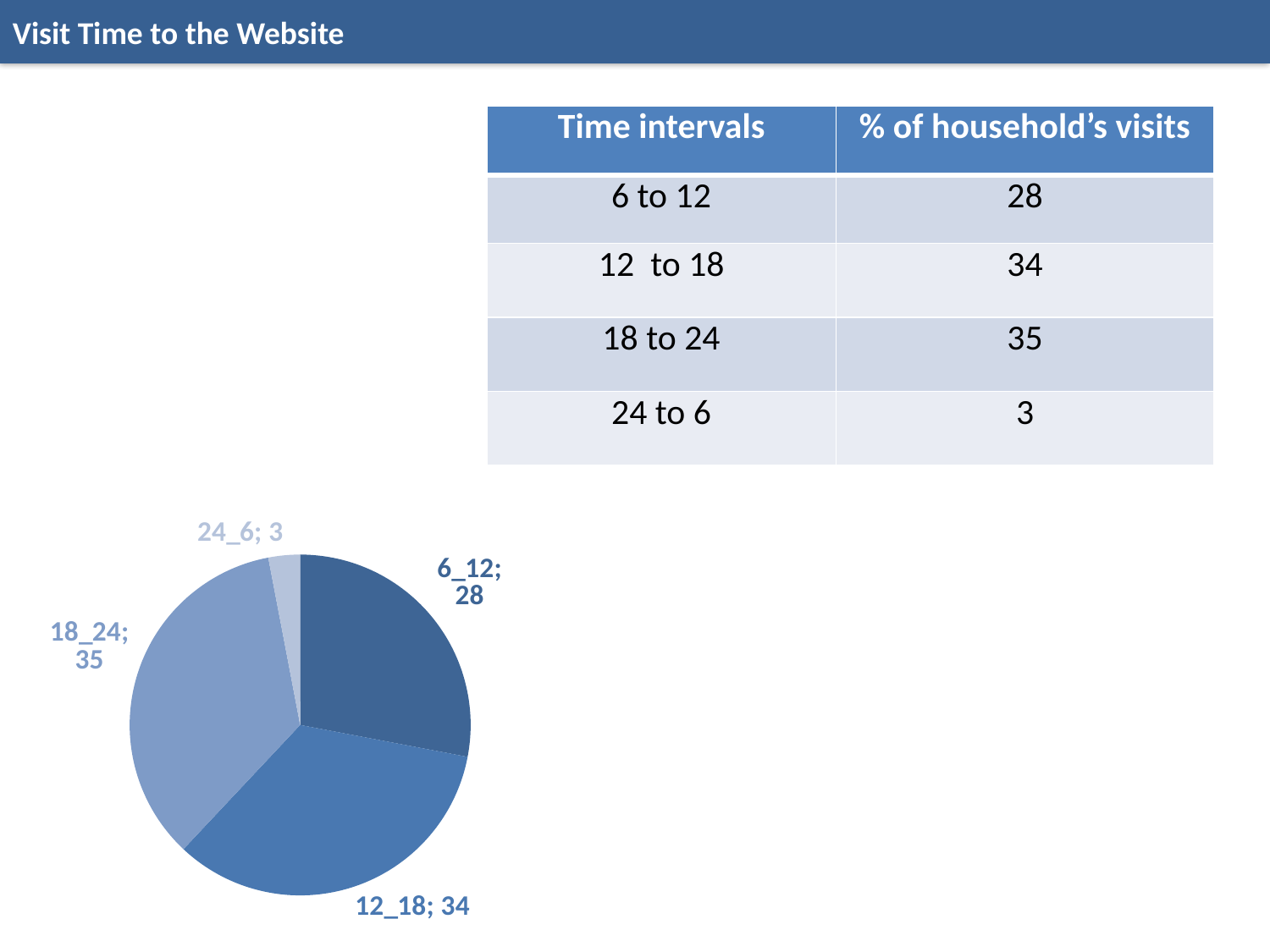
What is the difference between the 18_24 and 6_12 values in the pie chart? 7 What is the value shown for the 12_18 slice of the pie chart? 34 What kind of chart is shown on the slide? pie chart How many slices does the pie chart have? 4 Which slice of the pie chart has the largest value? 18_24 Which slice is larger in the pie chart, 6_12 or 12_18? 12_18 What is the value shown for the 6_12 slice of the pie chart? 28 Which slice of the pie chart has the smallest value? 24_6 What share of the pie does the 24_6 slice represent? 3% What is the value shown for the 24_6 slice of the pie chart? 3 What is the value shown for the 18_24 slice of the pie chart? 35 What is the total of all the slice values in the pie chart? 100